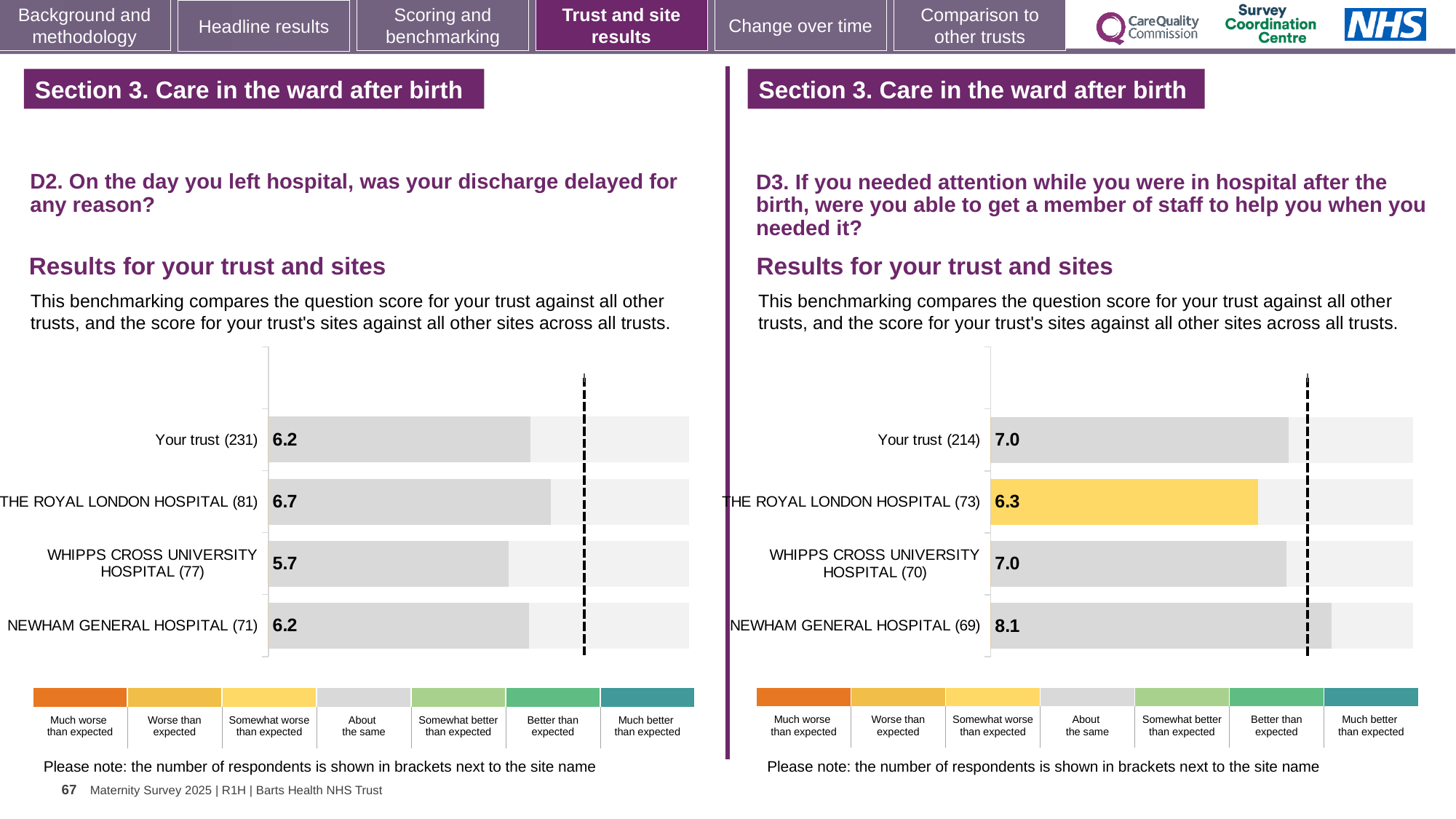
In the D3 chart (right), which site has the highest score? NEWHAM GENERAL HOSPITAL In the D2 chart (left), how many respondents are shown in brackets for Your trust? 231 In the D3 chart (right), which site's bar is coloured yellow, indicating 'Somewhat worse than expected'? THE ROYAL LONDON HOSPITAL In the D3 chart (right), which site has the lowest score? THE ROYAL LONDON HOSPITAL How many bars are plotted in the D2 chart (left)? 4 In the D2 chart (left), what is the difference between the scores for THE ROYAL LONDON HOSPITAL and WHIPPS CROSS UNIVERSITY HOSPITAL? 1.0 In the D3 chart (right), which is larger: the score for Your trust or the score for THE ROYAL LONDON HOSPITAL? Your trust In the D3 chart (right), what is the score for NEWHAM GENERAL HOSPITAL? 8.1 What type of chart is used in the D3 chart (right)? Bar chart In the D3 chart (right), what is the difference between the scores for NEWHAM GENERAL HOSPITAL and Your trust? 1.1 In the D2 chart (left), which site has the lowest score? WHIPPS CROSS UNIVERSITY HOSPITAL In the D2 chart (left), what is the score for THE ROYAL LONDON HOSPITAL? 6.7